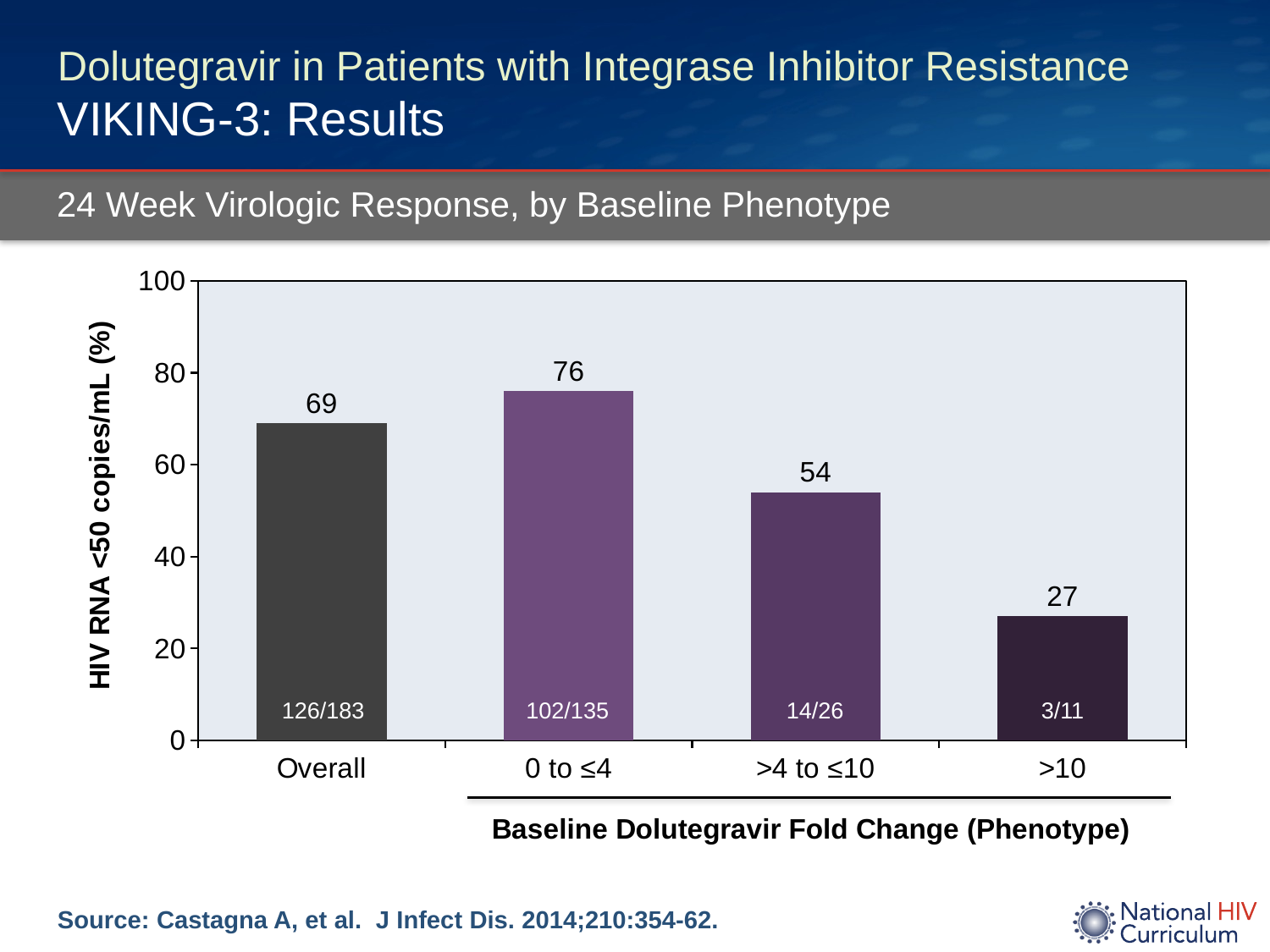
What is the value for the >10 baseline dolutegravir fold change category? 27 What is the label of the y axis? HIV RNA <50 copies/mL (%) Is the value for >4 to ≤10 greater or less than 60? less How many categories are shown on the x axis? 4 What is the difference between the values for 0 to ≤4 and >4 to ≤10? 22 What is the value for the 0 to ≤4 baseline dolutegravir fold change category? 76 What kind of chart is shown on the slide? Bar chart Which category has the highest value? 0 to ≤4 Which category has the lowest value? >10 What is the value for the Overall category? 69 Which is larger, the value for Overall or the value for >4 to ≤10? Overall What fraction is printed inside the bar for the >4 to ≤10 category? 14/26